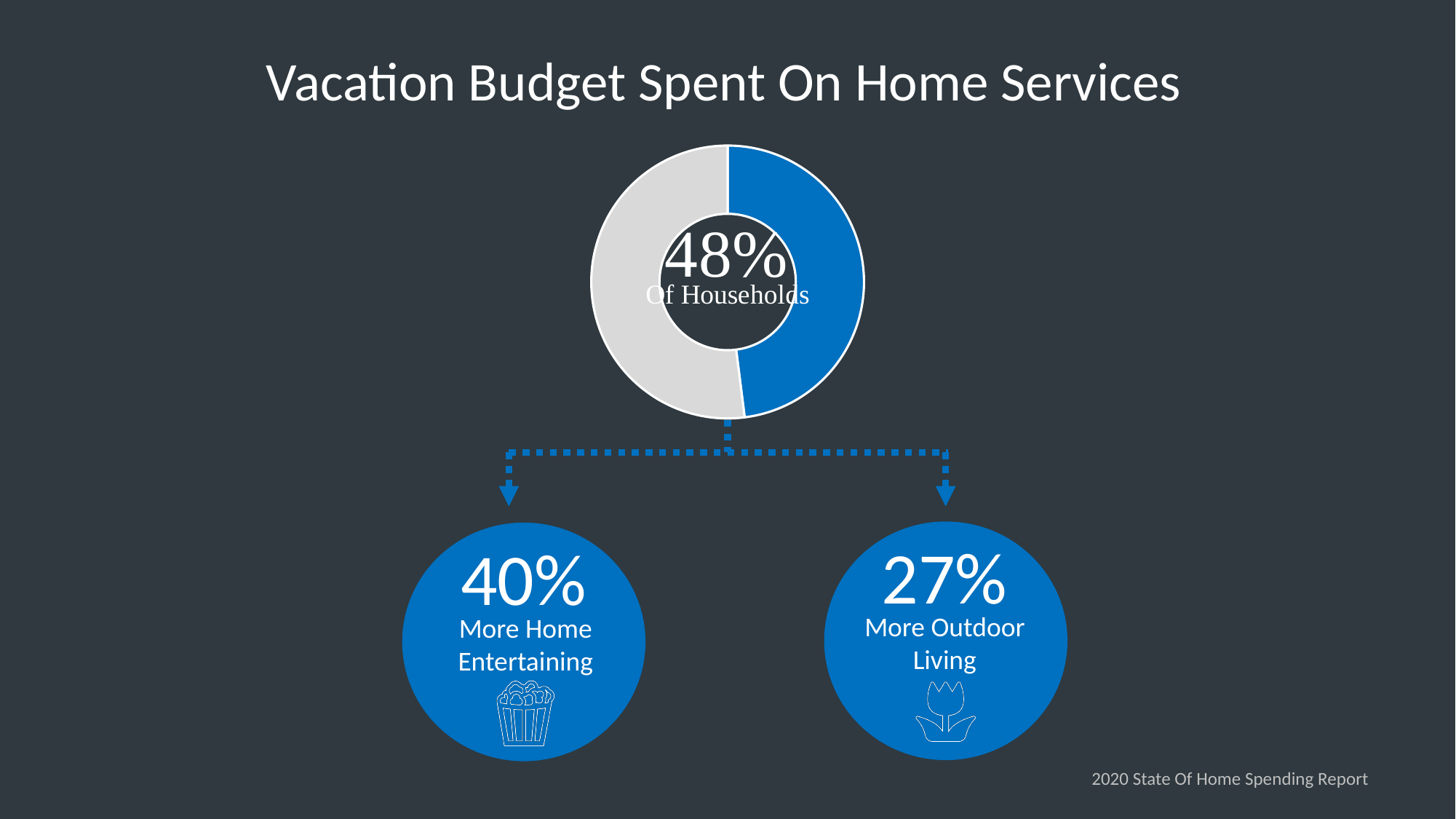
What label accompanies the 48% figure in the donut chart? Of Households Is the blue slice of the donut chart greater or less than 50%? less How many slices does the donut chart have? 2 Which is higher, More Home Entertaining or More Outdoor Living? More Home Entertaining What is the title of the chart on the slide? Vacation Budget Spent On Home Services What share of the donut chart does the blue slice represent? 48% What is the difference between the More Home Entertaining and More Outdoor Living percentages? 13% What kind of chart is shown at the top of the slide? Donut (pie) chart What percentage is shown in the centre of the donut chart? 48% Which slice of the donut chart is larger, the blue slice or the grey slice? The grey slice What percentage is shown for More Home Entertaining below the chart? 40% What percentage is shown for More Outdoor Living below the chart? 27%